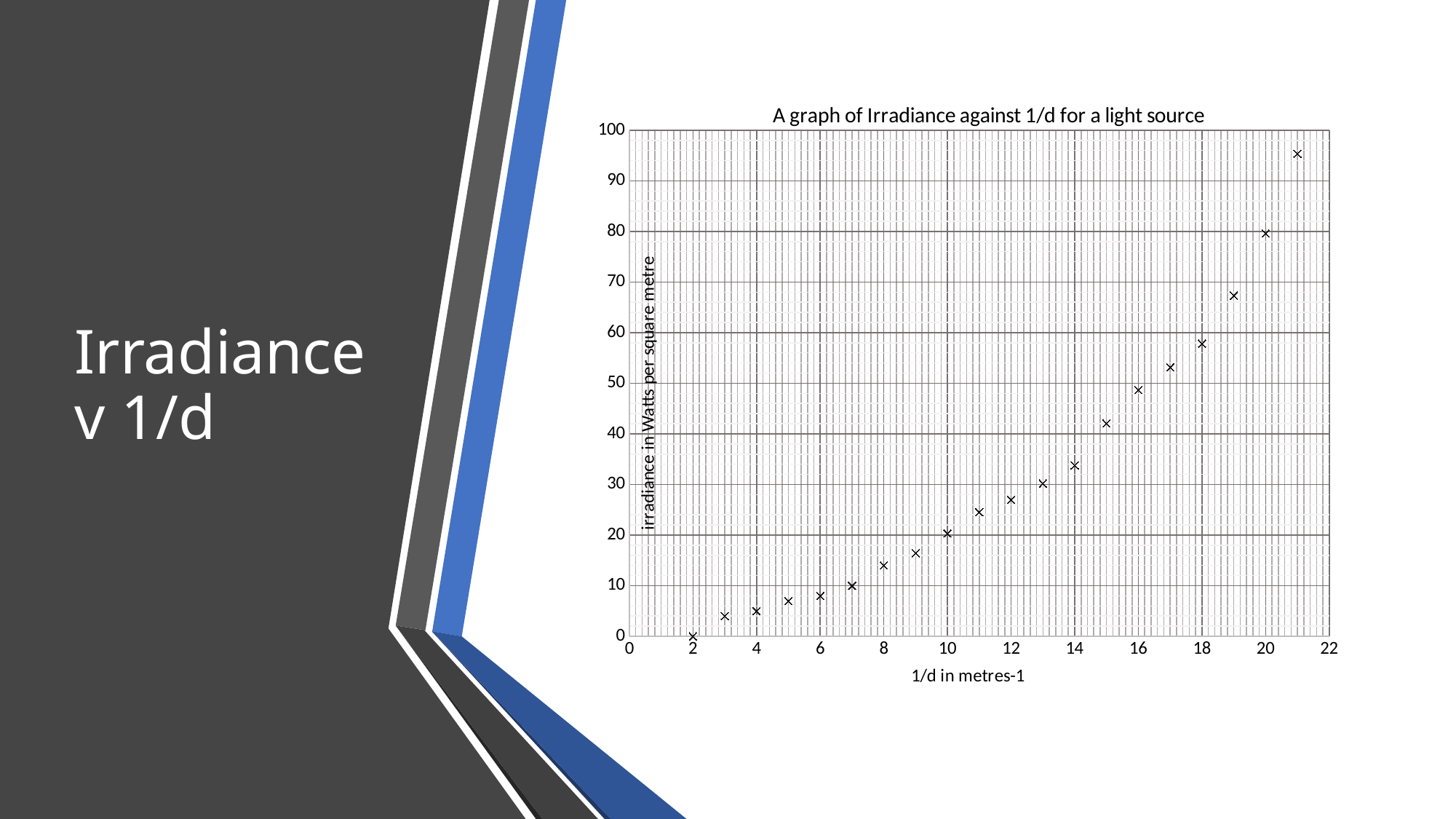
Is the irradiance at 1/d = 5 greater or less than 10? less Is the irradiance at 1/d = 21 greater or less than 90? greater How many data points are plotted on the chart? 20 What is the label on the vertical axis of the chart? irradiance in Watts per square metre Is the irradiance at 1/d = 15 greater or less than 40? greater Which has the larger irradiance, 1/d = 19 or 1/d = 20? 20 What is the title of the chart? A graph of Irradiance against 1/d for a light source At which value of 1/d is the irradiance highest? 21 What kind of chart is shown on the slide? scatter chart At which value of 1/d is the irradiance lowest? 2 Do the irradiance values rise or fall as 1/d increases along the x axis? rise